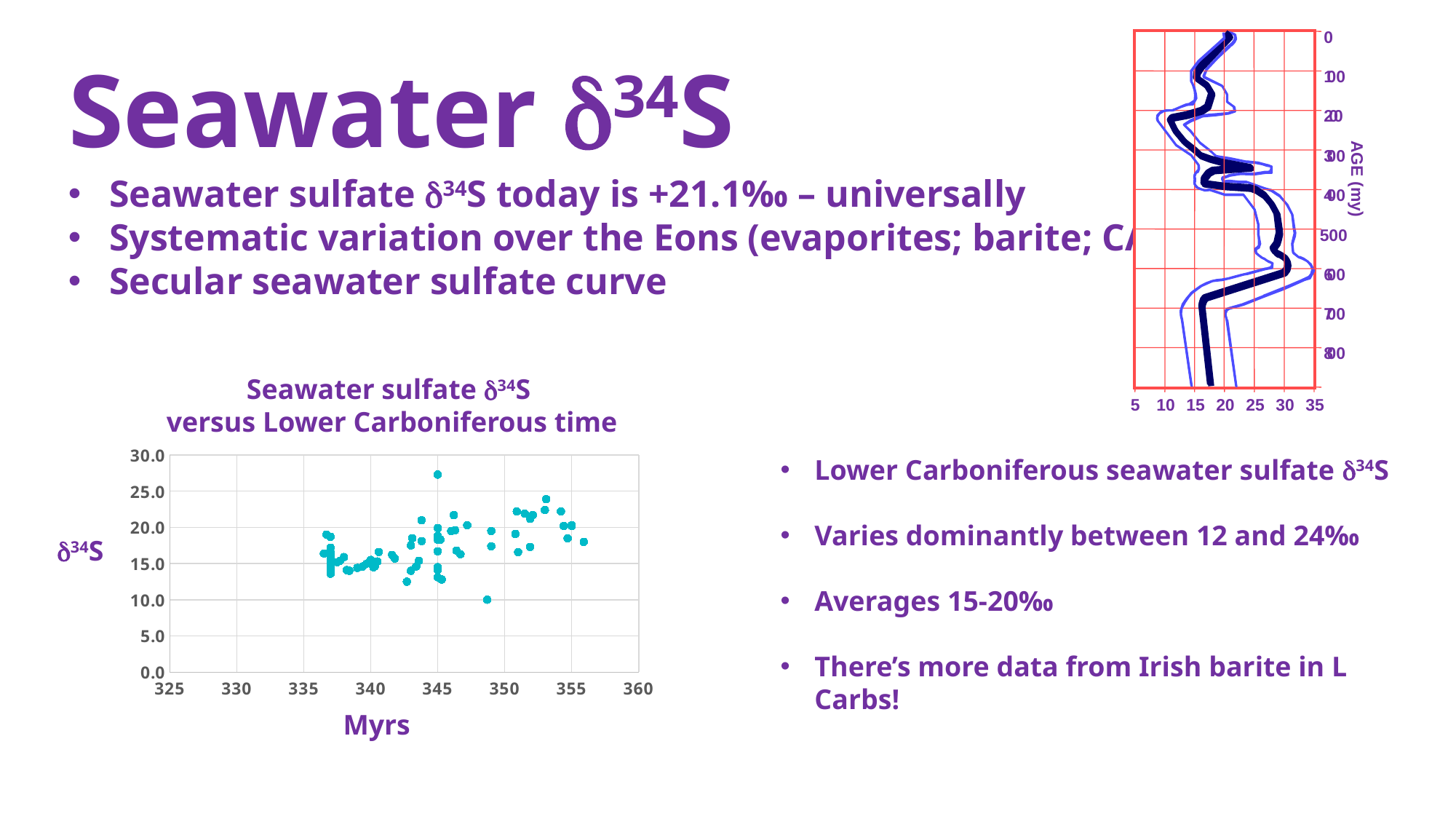
In the scatter chart 'Seawater sulfate δ34S versus Lower Carboniferous time', is the lowest plotted δ34S value greater or less than 15.0? less In the scatter chart 'Seawater sulfate δ34S versus Lower Carboniferous time', do the δ34S values generally rise or fall as Myrs increases from about 337 to about 353? rise What kind of chart is the secular seawater sulfate curve at the top right of the slide? Line chart In the secular seawater sulfate curve chart at the top right of the slide, what range do the horizontal axis ticks span? 5 to 35 What kind of chart is 'Seawater sulfate δ34S versus Lower Carboniferous time'? Scatter chart In the scatter chart 'Seawater sulfate δ34S versus Lower Carboniferous time', what is the label of the x axis? Myrs What is the title of the chart in the lower left of the slide? Seawater sulfate δ34S versus Lower Carboniferous time In the scatter chart 'Seawater sulfate δ34S versus Lower Carboniferous time', are any points plotted at x values below 335 Myrs? No In the scatter chart 'Seawater sulfate δ34S versus Lower Carboniferous time', what range does the x axis span? 325 to 360 In the scatter chart 'Seawater sulfate δ34S versus Lower Carboniferous time', what is the highest tick value shown on the y axis? 30.0 In the scatter chart 'Seawater sulfate δ34S versus Lower Carboniferous time', is the highest plotted δ34S value greater or less than 25.0? greater In the secular seawater sulfate curve chart at the top right of the slide, what is the label of the vertical axis? AGE (my)